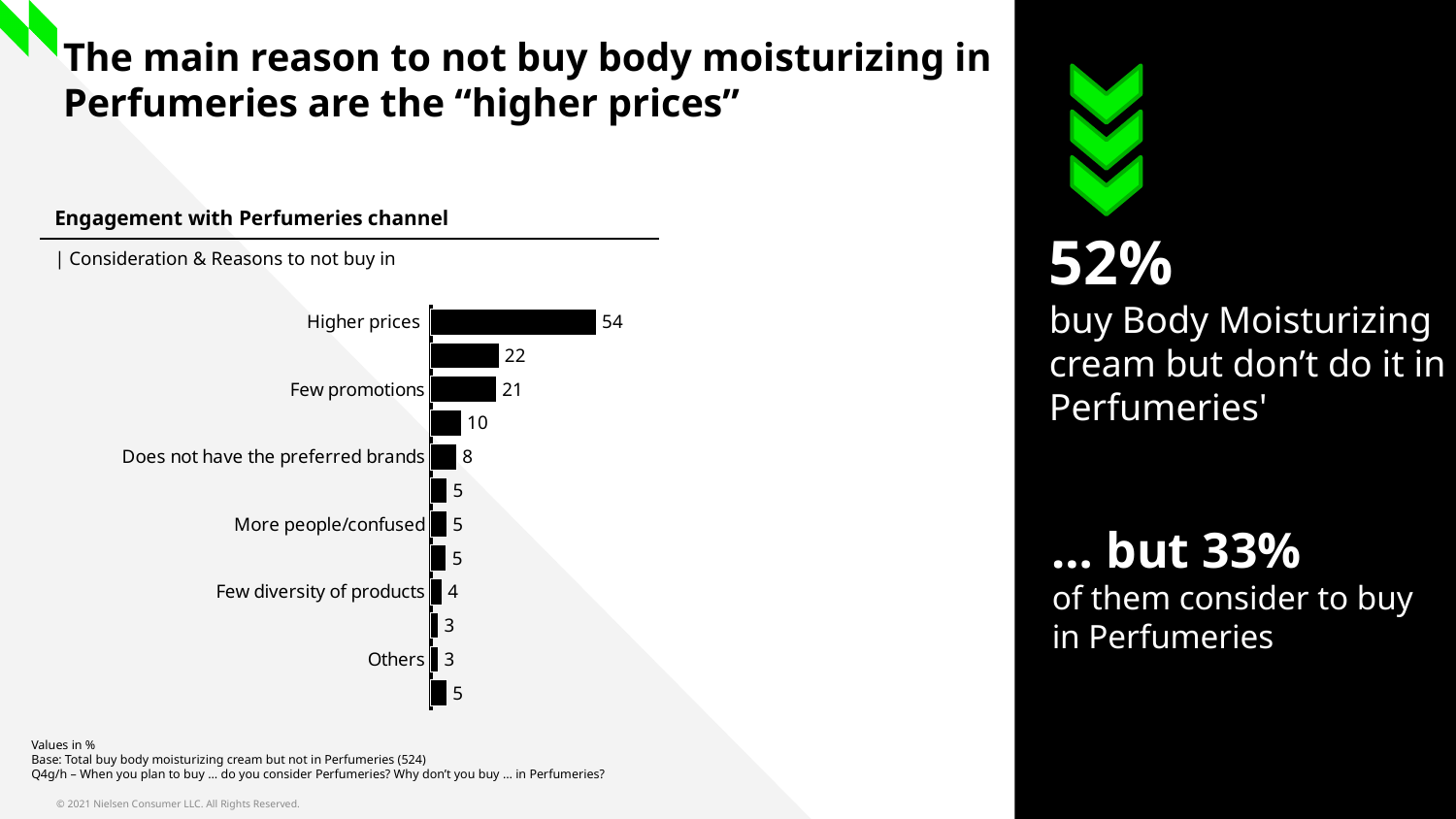
Which is larger, the value for "Few promotions" or the value for "Does not have the preferred brands"? Few promotions What is the value for "Few promotions"? 21 What is the difference between the values for "Higher prices" and "Few promotions"? 33 What type of chart is shown on the slide? Bar chart How many bars are plotted in the chart? 12 Which labelled reason has the highest value? Higher prices What is the value for "Does not have the preferred brands"? 8 What is the value for "Few diversity of products"? 4 What is the subtitle shown above the chart, below "Engagement with Perfumeries channel"? Consideration & Reasons to not buy in What is the value for "More people/confused"? 5 What is the value for "Higher prices"? 54 What is the value for "Others"? 3